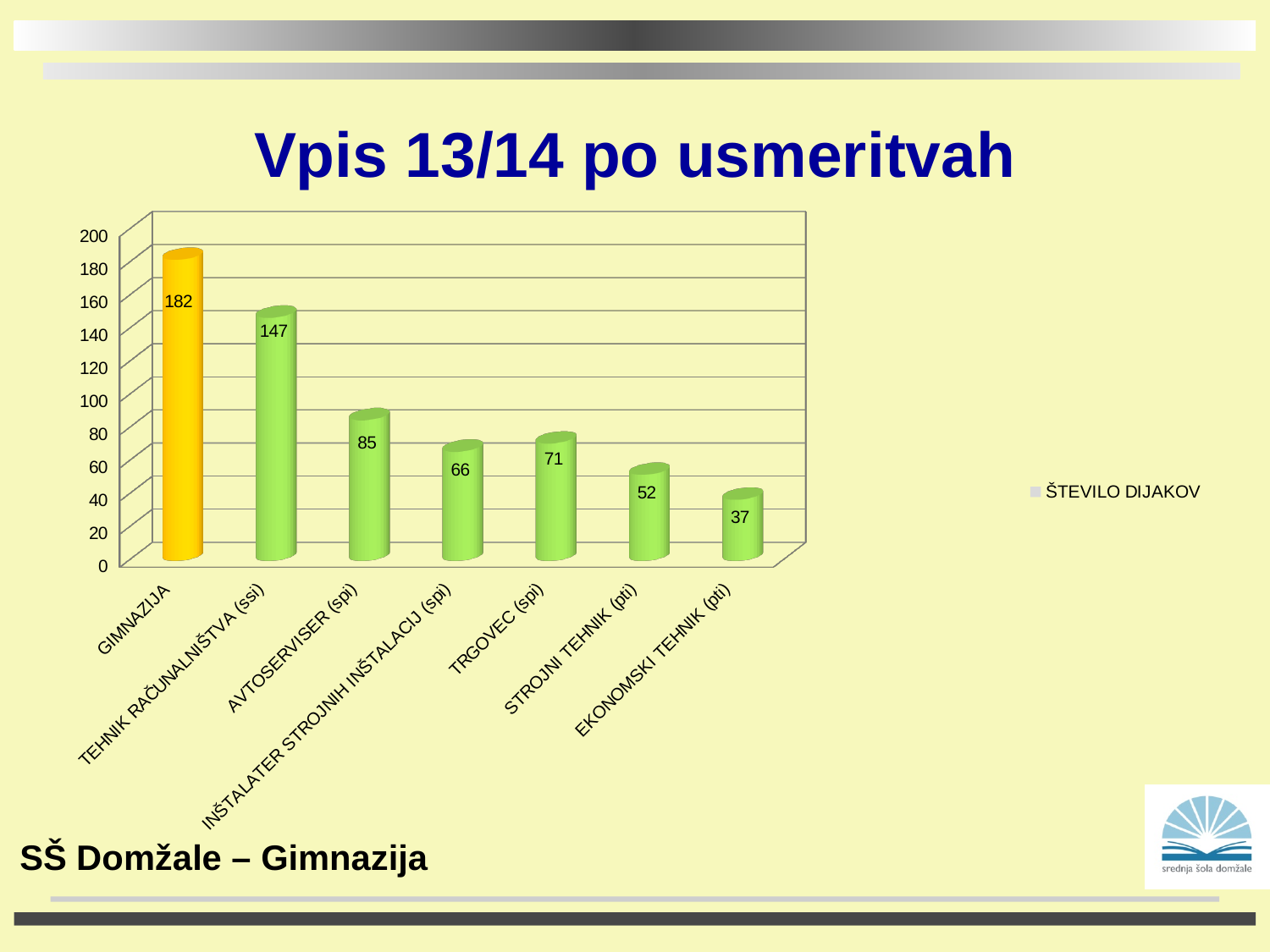
What is the value for EKONOMSKI TEHNIK (pti)? 37 Which is larger, the value for TRGOVEC (spi) or the value for INŠTALATER STROJNIH INŠTALACIJ (spi)? TRGOVEC (spi) What is the value for GIMNAZIJA? 182 Is the value for AVTOSERVISER (spi) greater or less than 100? less How many series does the legend list? 1 Which category has the lowest value? EKONOMSKI TEHNIK (pti) What is the difference between the values for GIMNAZIJA and TEHNIK RAČUNALNIŠTVA (ssi)? 35 What kind of chart is shown on the slide? bar chart How many categories are shown on the x axis? 7 What is the title of the chart? Vpis 13/14 po usmeritvah Which category has the highest value? GIMNAZIJA What is the value for TEHNIK RAČUNALNIŠTVA (ssi)? 147